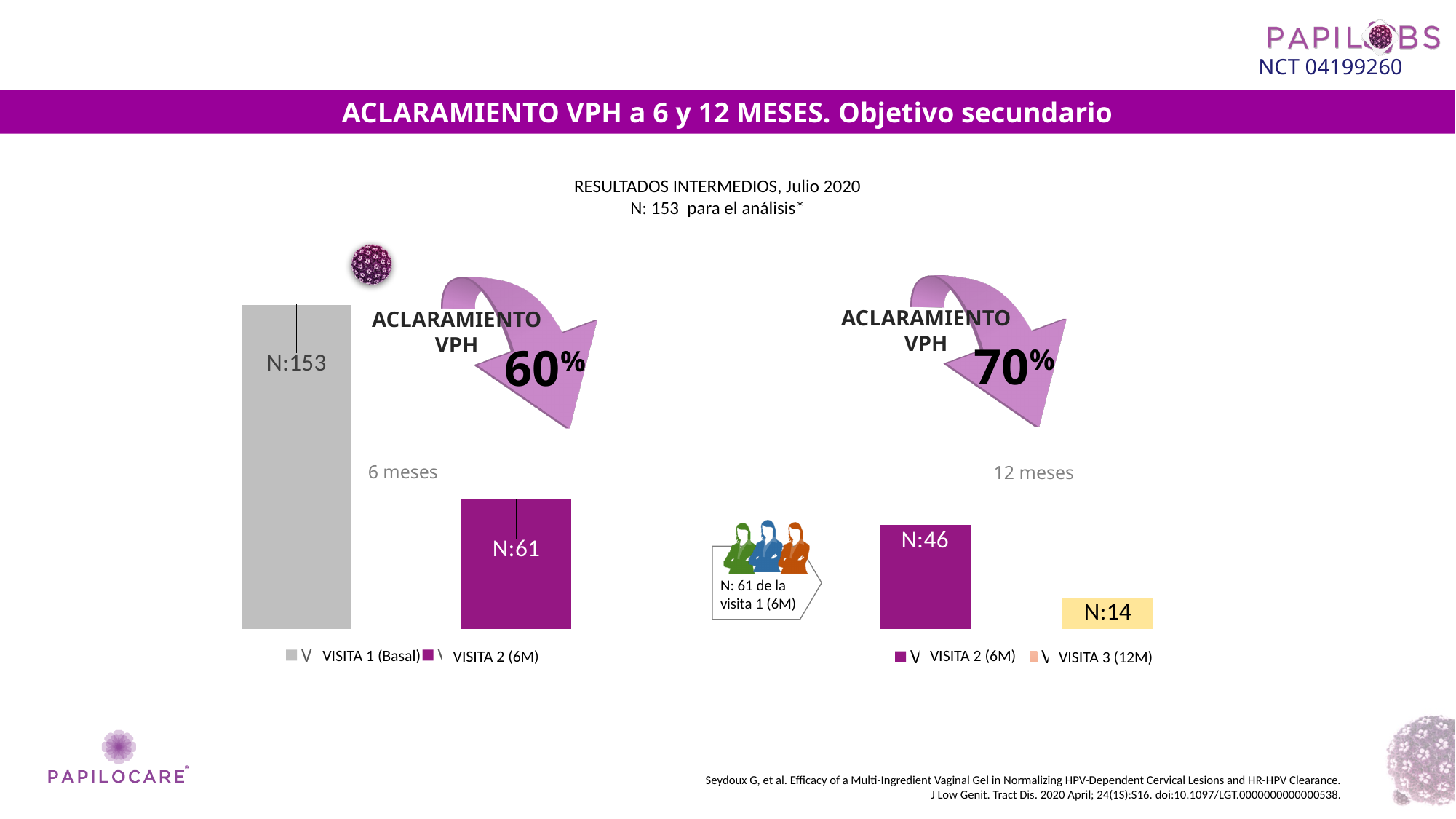
In the left chart (6 meses), which bar is the tallest? VISITA 1 (Basal) What kind of chart is the right chart (12 meses)? Bar chart In the right chart (12 meses), what value is shown for VISITA 2 (6M)? N:46 In the right chart (12 meses), which bar is the lowest? VISITA 3 (12M) In the left chart (6 meses), what is the difference between the VISITA 1 (Basal) value and the VISITA 2 (6M) value? 92 In the right chart (12 meses), which is larger: VISITA 2 (6M) or VISITA 3 (12M)? VISITA 2 (6M) How many series does the legend of the left chart (6 meses) list? 2 In the right chart (12 meses), what is the difference between the VISITA 2 (6M) value and the VISITA 3 (12M) value? 32 In the left chart (6 meses), what value is shown for VISITA 1 (Basal)? N:153 In the left chart (6 meses), what value is shown for VISITA 2 (6M)? N:61 In the right chart (12 meses), what colour is the VISITA 3 (12M) bar? Light yellow In the right chart (12 meses), what value is shown for VISITA 3 (12M)? N:14